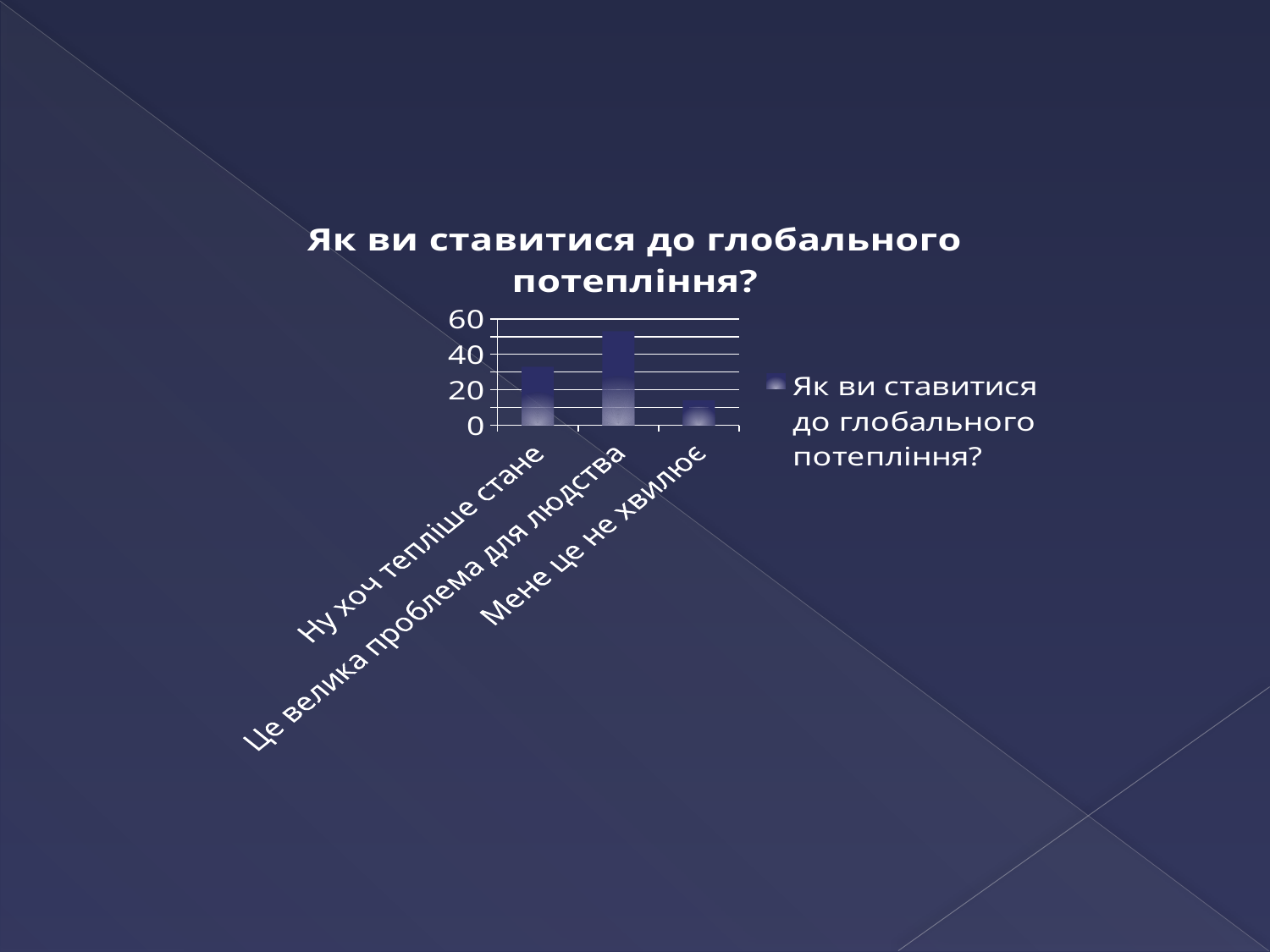
Is the value for "Мене це не хвилює" greater or less than 20? less Is the value for "Ну хоч тепліше стане" greater or less than 20? greater What is the title of the chart? Як ви ставитися до глобального потепління? How many series does the legend list? 1 What is the highest value shown on the vertical axis of the chart? 60 What kind of chart is shown on the slide? bar chart Which is larger: the value for "Ну хоч тепліше стане" or the value for "Мене це не хвилює"? Ну хоч тепліше стане Is the value for "Це велика проблема для людства" greater or less than 40? greater How many categories are plotted on the x axis of the chart? 3 Which category has the highest value? Це велика проблема для людства Which category has the lowest value? Мене це не хвилює